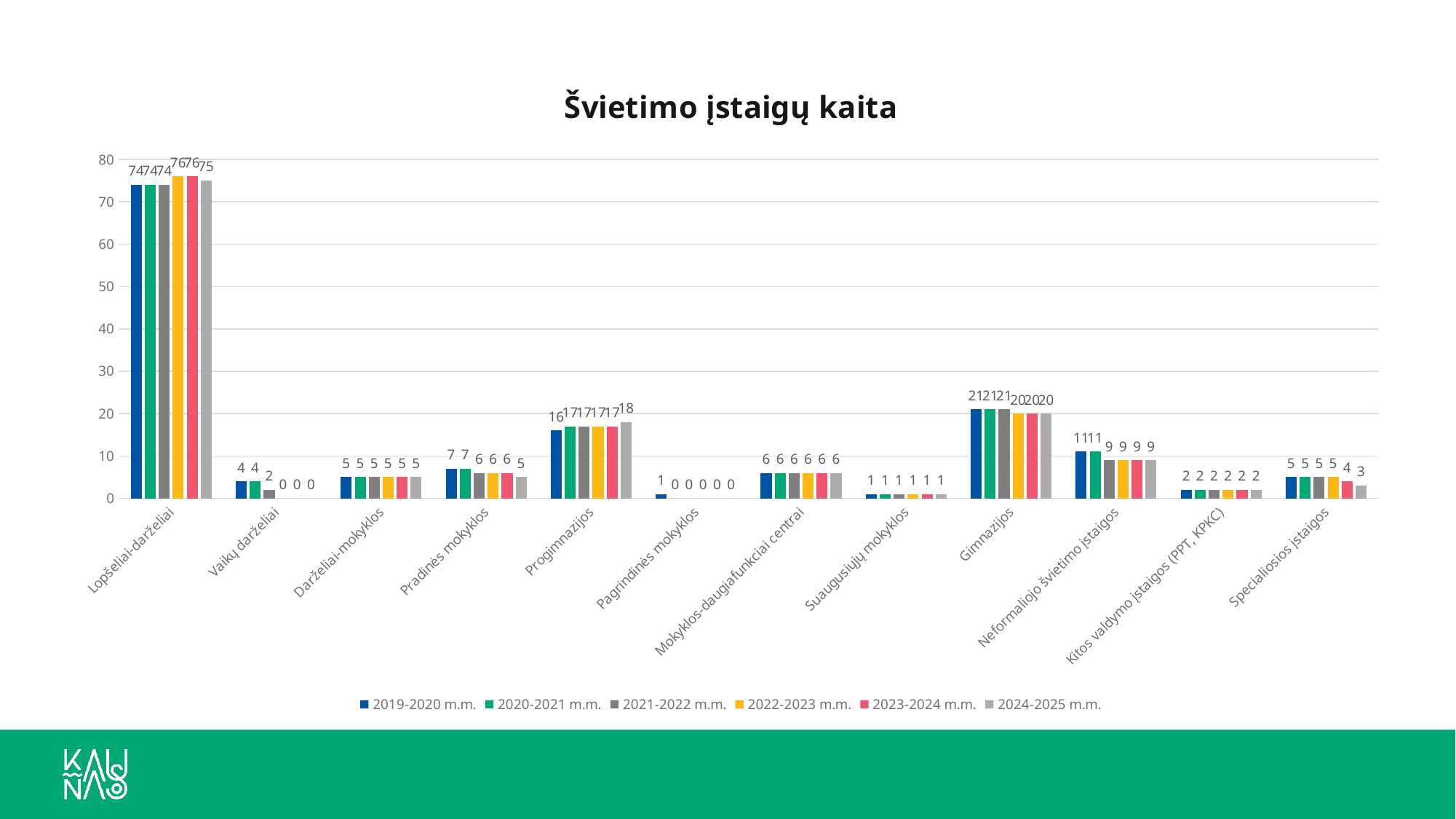
How many categories are shown on the x axis? 12 What is the difference between the 2022-2023 m.m. and 2019-2020 m.m. values for Lopšeliai-darželiai? 2 What kind of chart is shown on the slide? bar chart Do the values for Specialiosios įstaigos rise or fall from 2019-2020 m.m. to 2024-2025 m.m.? fall What is the value for Neformaliojo švietimo įstaigos in 2021-2022 m.m.? 9 What is the value for Lopšeliai-darželiai in 2024-2025 m.m.? 75 What is the title of the chart? Švietimo įstaigų kaita What is the value for Progimnazijos in 2019-2020 m.m.? 16 Which category has the highest value in 2022-2023 m.m.? Lopšeliai-darželiai How many series does the legend list? 6 What is the value for Vaikų darželiai in 2021-2022 m.m.? 2 Which is larger for Gimnazijos: the 2019-2020 m.m. value or the 2024-2025 m.m. value? 2019-2020 m.m.